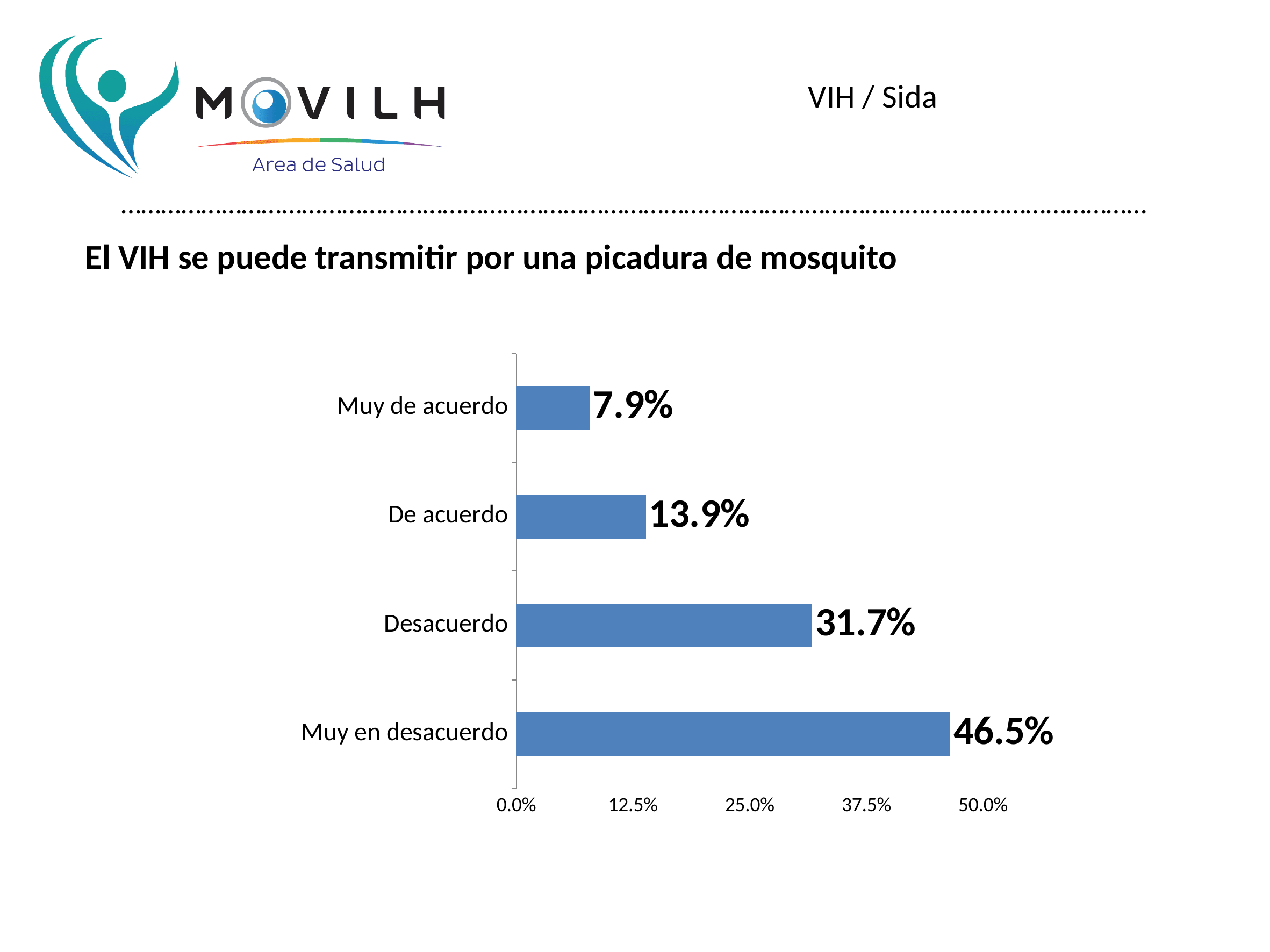
What is the difference between the values for "De acuerdo" and "Muy de acuerdo"? 6.0% What kind of chart is shown on the slide? bar chart What is the value for "Muy de acuerdo"? 7.9% Is the value for "Desacuerdo" greater or less than 25.0%? greater What is the difference between the values for "Muy en desacuerdo" and "Desacuerdo"? 14.8% What is the value for "Desacuerdo"? 31.7% What is the value for "Muy en desacuerdo"? 46.5% What is the value for "De acuerdo"? 13.9% Which is larger, the value for "Desacuerdo" or the value for "De acuerdo"? Desacuerdo How many categories are shown in the chart? 4 Which category has the highest value? Muy en desacuerdo Which category has the lowest value? Muy de acuerdo